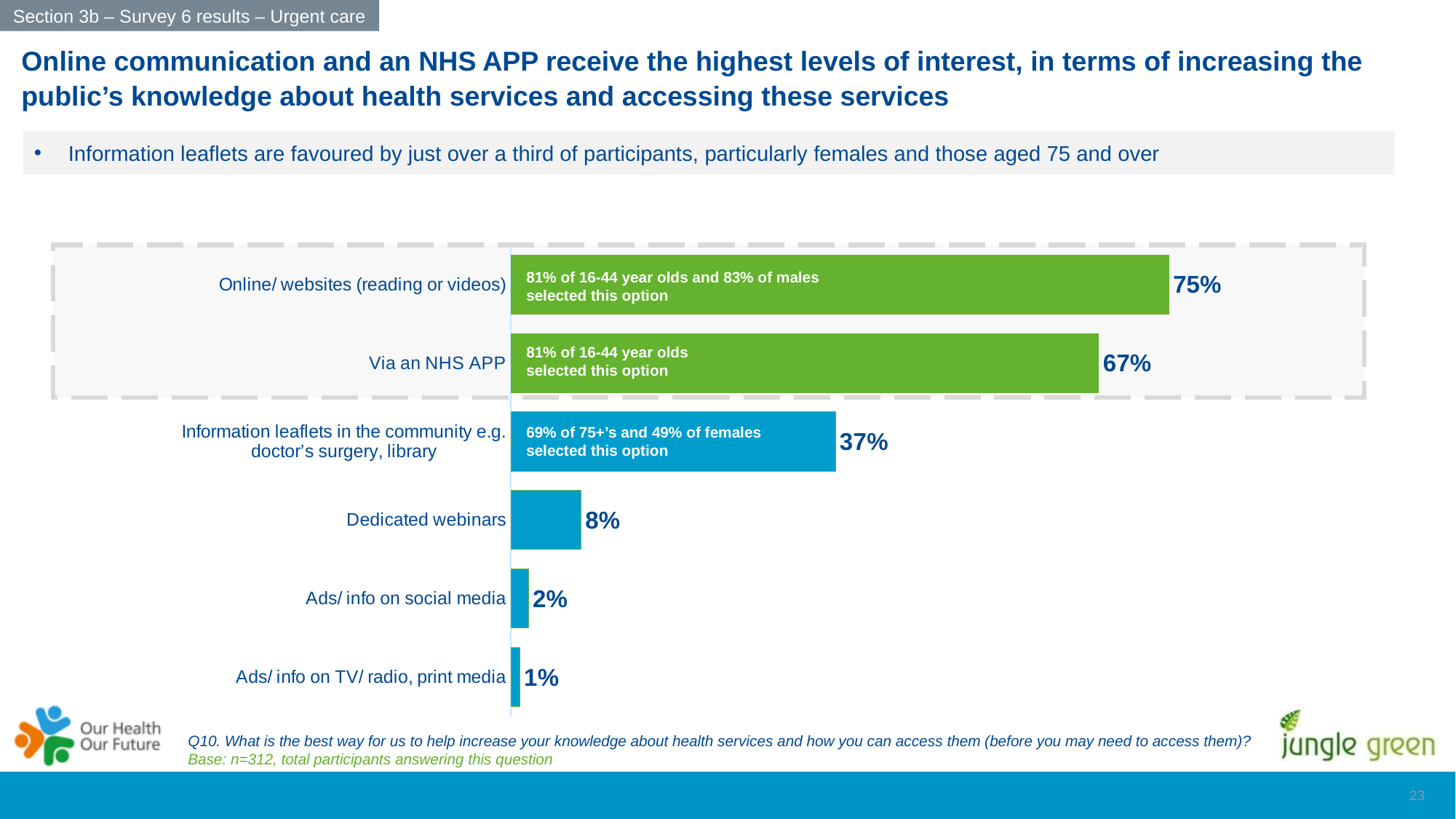
Which is larger: the value for 'Ads/ info on social media' or 'Ads/ info on TV/ radio, print media'? Ads/ info on social media What colour are the bars for the two highest categories, 'Online/ websites' and 'Via an NHS APP'? Green What percentage of participants selected 'Online/ websites (reading or videos)'? 75% Which category has the highest value in the chart? Online/ websites (reading or videos) What is the value for 'Dedicated webinars'? 8% What kind of chart is shown on the slide? Bar chart What percentage selected 'Information leaflets in the community e.g. doctor's surgery, library'? 37% What is the difference between the values for 'Online/ websites (reading or videos)' and 'Via an NHS APP'? 8% How many categories are shown in the chart? 6 What is the difference between 'Information leaflets in the community' and 'Dedicated webinars'? 29% What is the value shown for 'Via an NHS APP'? 67% Which category has the lowest value in the chart? Ads/ info on TV/ radio, print media